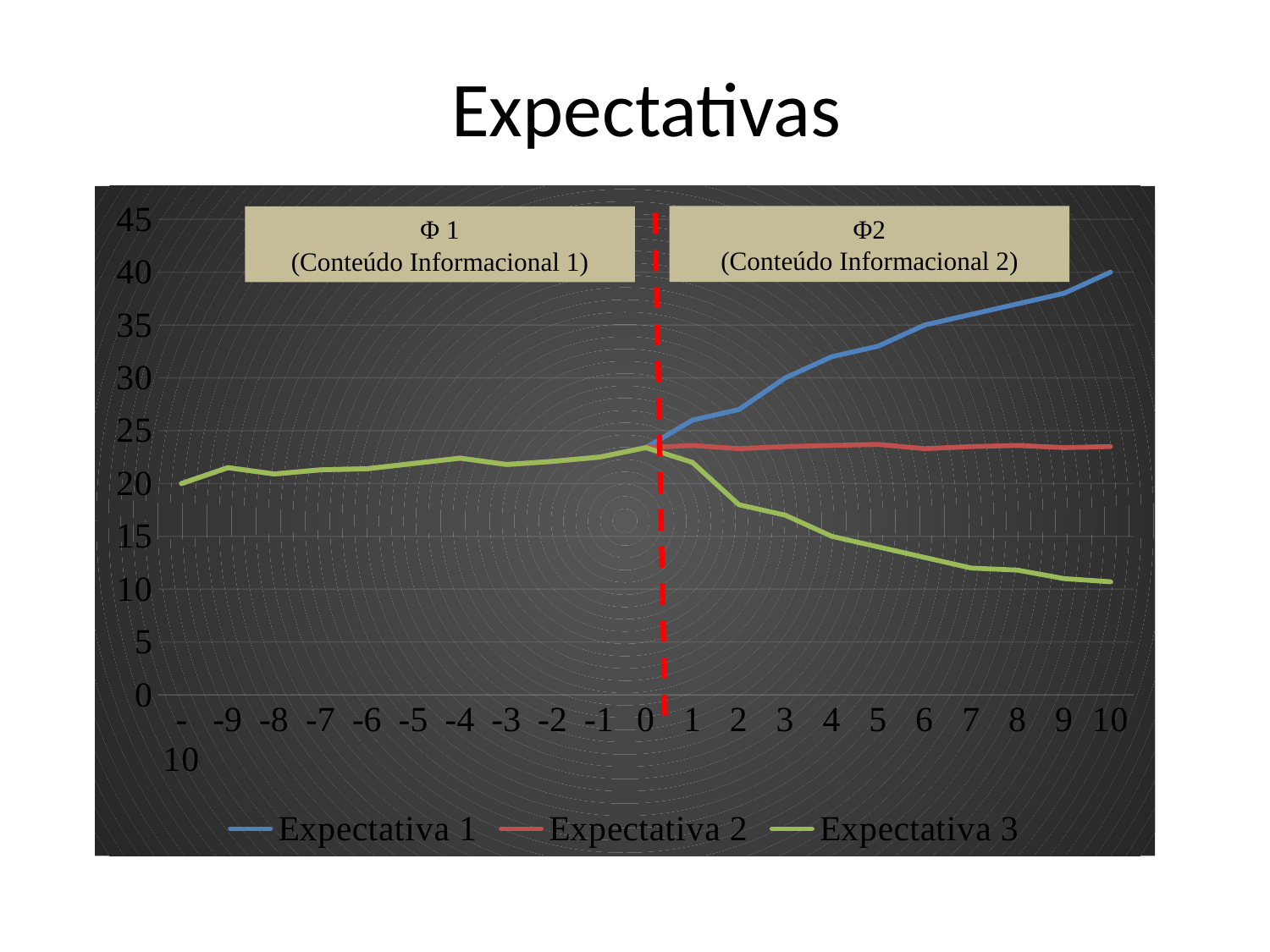
Which series has the highest value at x = 10? Expectativa 1 Does Expectativa 3 rise or fall from x = 0 to x = 10? Fall Is the value of Expectativa 1 at x = 10 greater or less than 35? greater At x = 10, which is larger: Expectativa 1 or Expectativa 3? Expectativa 1 How many points are on the x axis (from -10 to 10)? 21 Is the value of Expectativa 3 at x = 10 greater or less than 15? less Which series has the lowest value at x = 10? Expectativa 3 What is the title of the slide? Expectativas How many series does the legend list? 3 Does Expectativa 1 rise or fall from x = 0 to x = 10? Rise What kind of chart is shown on the slide? Line chart Is the value of Expectativa 2 at x = 5 greater or less than 20? greater